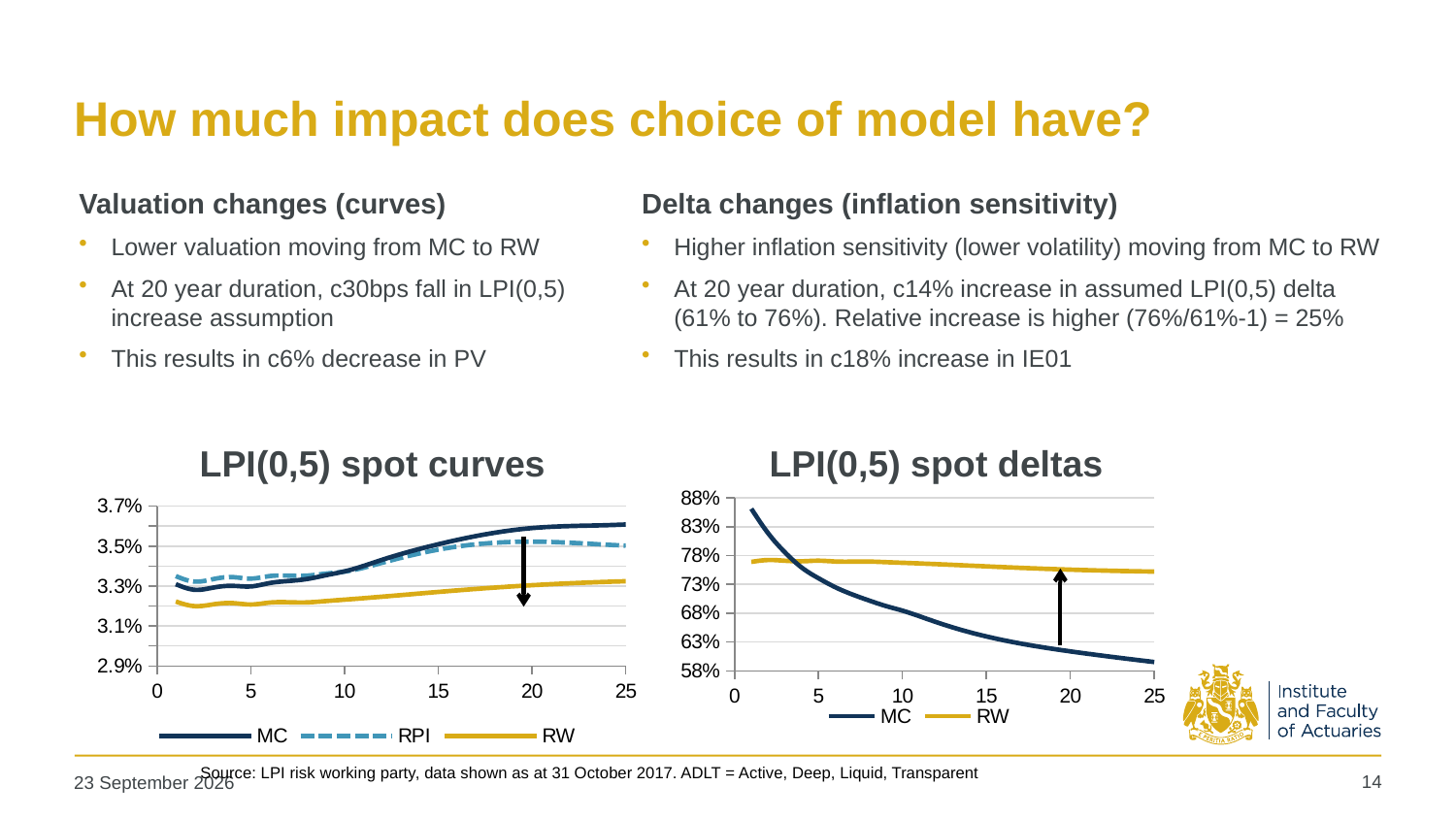
In the 'LPI(0,5) spot curves' chart, which series is higher at 20 years, MC or RW? MC In the 'LPI(0,5) spot deltas' chart, is the MC value at 25 years greater or less than 63%? less In the 'LPI(0,5) spot curves' chart, is the MC value at 25 years greater or less than 3.5%? greater In the 'LPI(0,5) spot curves' chart, is the RW value at 5 years greater or less than 3.3%? less In the 'LPI(0,5) spot deltas' chart, which series is higher at 20 years, MC or RW? RW What kind of chart is the 'LPI(0,5) spot curves' chart? line chart How many series does the legend of the 'LPI(0,5) spot curves' chart list? 3 Which series in the 'LPI(0,5) spot curves' chart is drawn with a dashed line? RPI In the 'LPI(0,5) spot deltas' chart, does the MC series rise or fall as duration increases? fall How many series does the legend of the 'LPI(0,5) spot deltas' chart list? 2